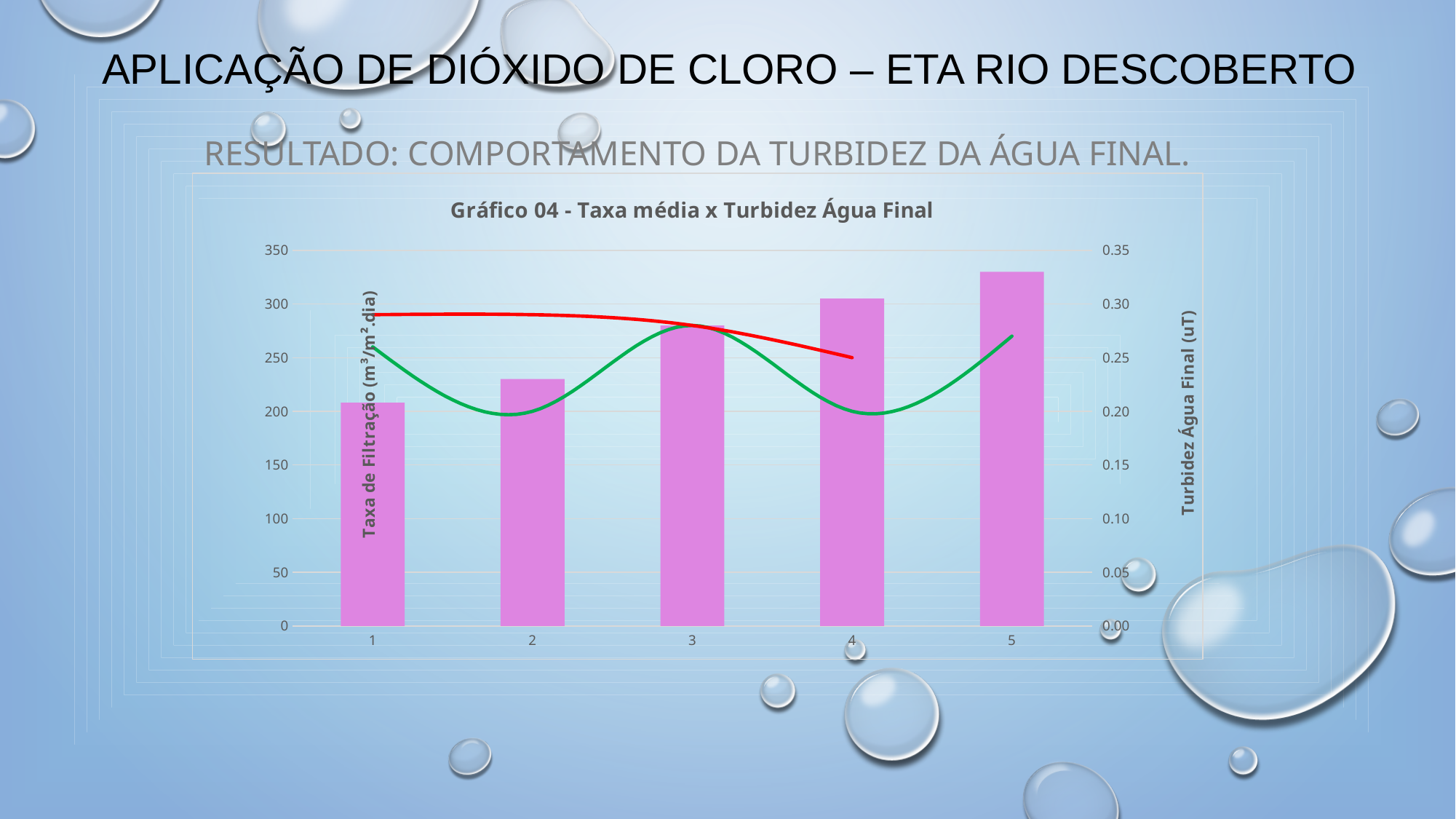
Is the bar value for category 5 greater or less than 300? greater Is the bar value for category 1 greater or less than 250? less What kind of chart is used to show the Taxa de Filtração values? bar chart What is the title of the chart on the slide? Gráfico 04 - Taxa média x Turbidez Água Final Do the bar values rise or fall from category 1 to category 5? rise Which category has the shortest bar in the chart? 1 How many categories are shown on the x axis of the chart? 5 What is the title of the right-hand vertical axis of the chart? Turbidez Água Final (uT) Which bar is taller, category 2 or category 3? 3 Is the bar value for category 2 greater or less than 250? less Which category has the tallest bar in the chart? 5